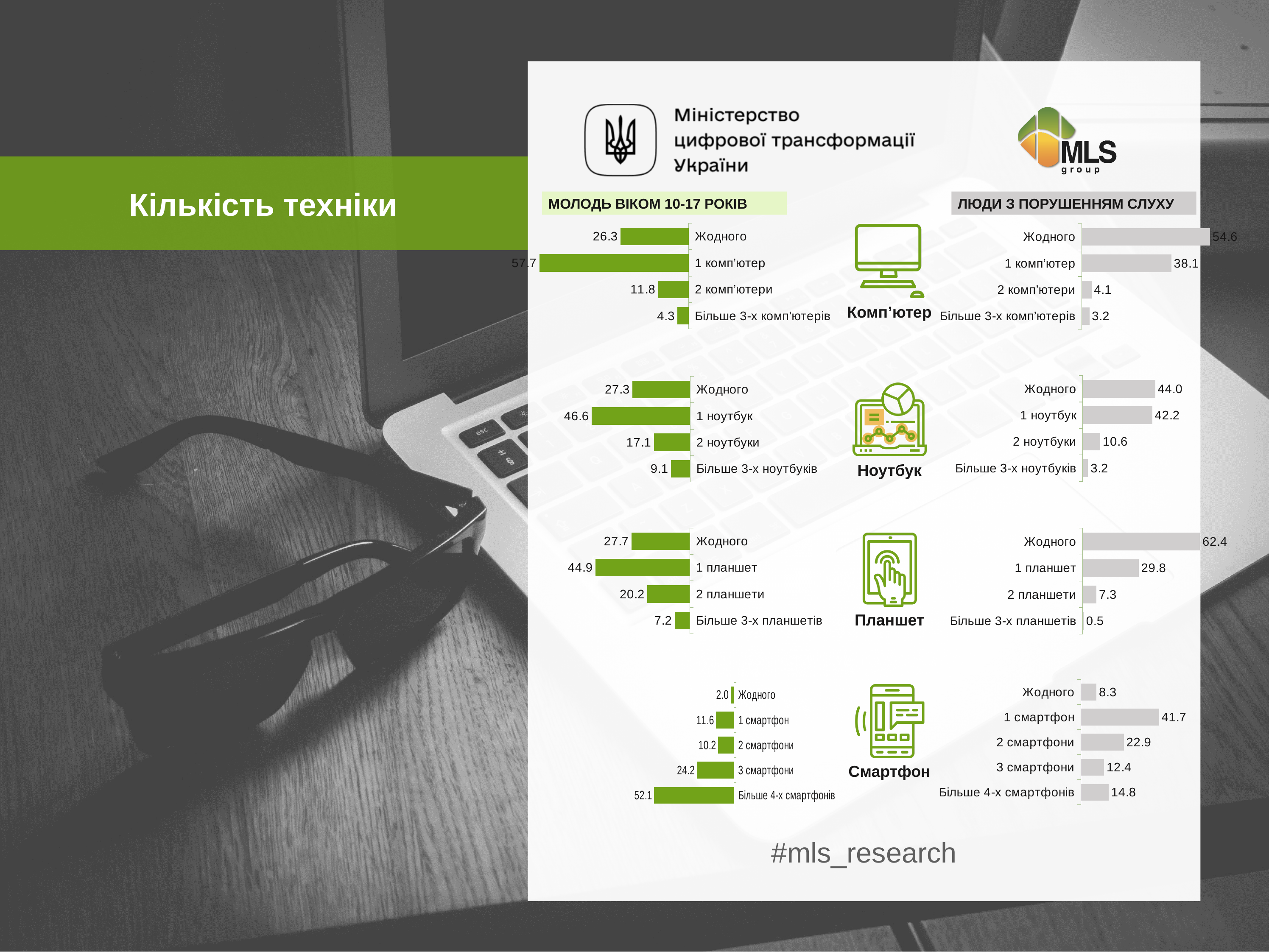
In the Ноутбук chart, what is the value for '2 ноутбуки' among Люди з порушенням слуху? 10.6 How many categories does the Ноутбук chart show for Люди з порушенням слуху? 4 In the Ноутбук chart, which category has the highest value among Молодь віком 10-17 років? 1 ноутбук In the Смартфон chart, which category has the highest value among Люди з порушенням слуху? 1 смартфон What colour are the bars for Молодь віком 10-17 років? Green In the Планшет chart, which is larger for 'Жодного': the value for Молодь віком 10-17 років or for Люди з порушенням слуху? Люди з порушенням слуху In the Комп'ютер chart, what is the value for 'Жодного' among Люди з порушенням слуху? 54.6 In the Комп'ютер chart, what is the value for '1 комп'ютер' among Молодь віком 10-17 років? 57.7 In the Смартфон chart, what is the difference between 'Більше 4-х смартфонів' for Молодь віком 10-17 років and for Люди з порушенням слуху? 37.3 What kind of chart is used to show the Комп'ютер data? Bar chart In the Планшет chart, which category has the lowest value among Люди з порушенням слуху? Більше 3-х планшетів How many categories does the Смартфон chart show for Молодь віком 10-17 років? 5